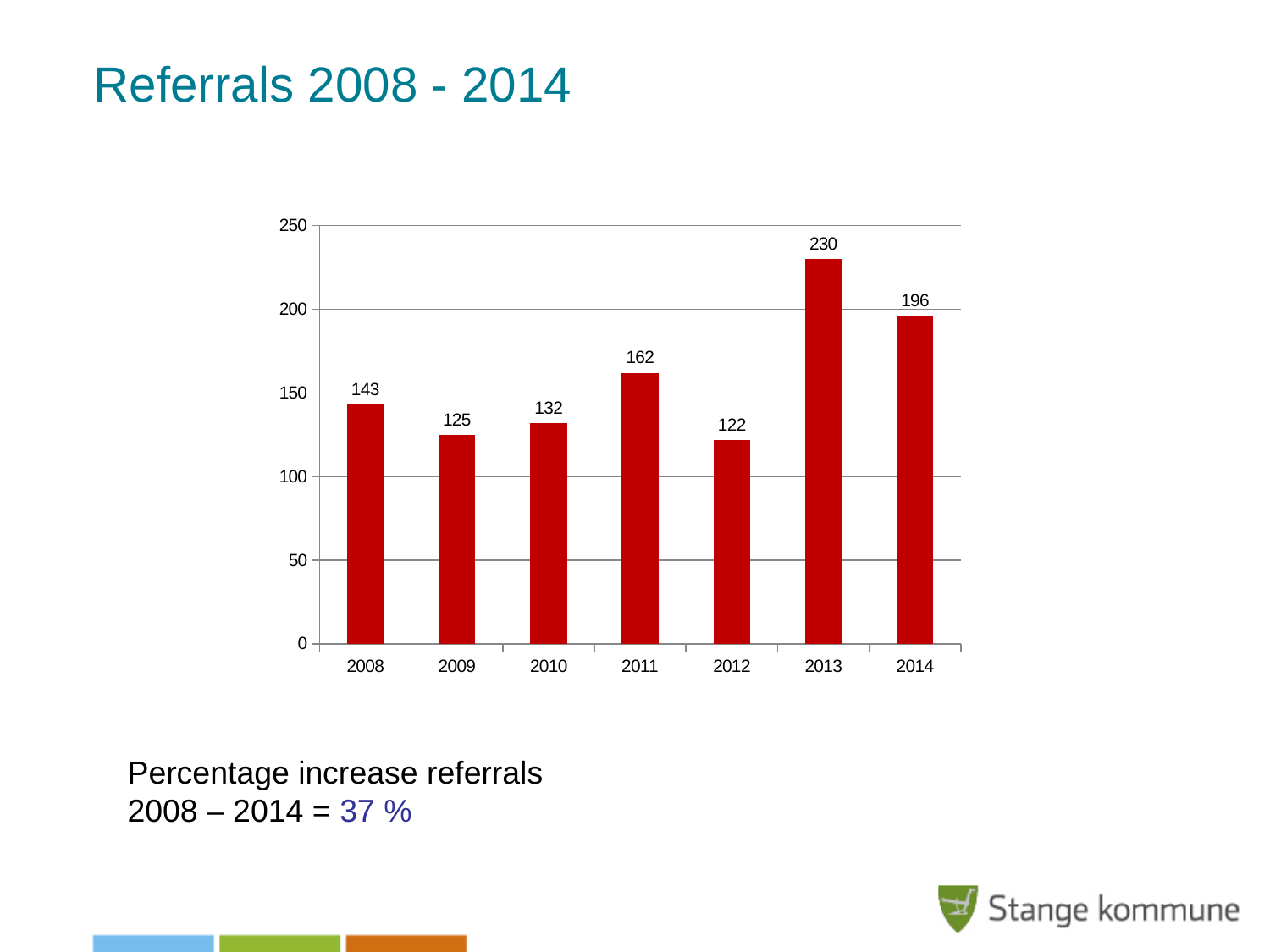
What is the difference in referrals between 2013 and 2014? 34 What is the number of referrals in 2012? 122 Which year has more referrals, 2009 or 2010? 2010 Which year has the lowest number of referrals? 2012 How many years are shown on the x axis? 7 What is the title of the slide containing the chart? Referrals 2008 - 2014 Which year has the highest number of referrals? 2013 What is the number of referrals in 2013? 230 Is the value for 2011 greater or less than 150? greater What is the number of referrals in 2008? 143 What kind of chart is shown on the slide? bar chart What is the difference in referrals between 2014 and 2008? 53